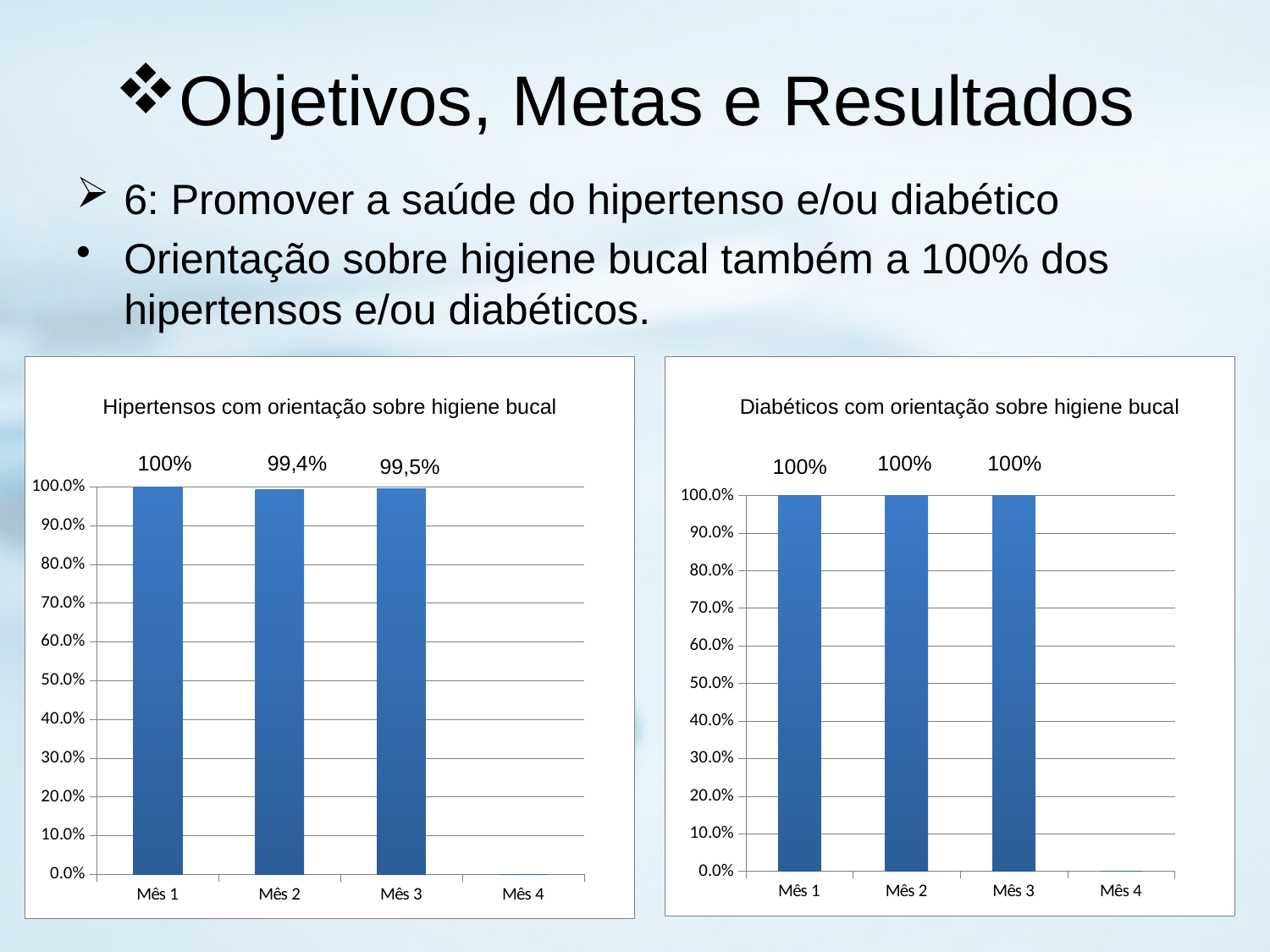
In the chart titled "Hipertensos com orientação sobre higiene bucal", how many bars are plotted? 3 What kind of chart is the chart on the right of the slide? Bar chart What is the title of the chart on the left of the slide? Hipertensos com orientação sobre higiene bucal In the chart titled "Hipertensos com orientação sobre higiene bucal", which month has the highest value? Mês 1 In the chart titled "Hipertensos com orientação sobre higiene bucal", what is the value for Mês 3? 99,5% In the chart titled "Hipertensos com orientação sobre higiene bucal", what is the difference between the values for Mês 1 and Mês 2? 0,6% In the chart titled "Diabéticos com orientação sobre higiene bucal", how many categories are labelled on the x axis? 4 In the chart titled "Hipertensos com orientação sobre higiene bucal", which is larger, the value for Mês 2 or Mês 3? Mês 3 In the chart titled "Hipertensos com orientação sobre higiene bucal", what is the value for Mês 2? 99,4% In the chart titled "Diabéticos com orientação sobre higiene bucal", what is the value for Mês 2? 100% In the chart titled "Diabéticos com orientação sobre higiene bucal", is the value for Mês 3 greater or less than 90%? greater